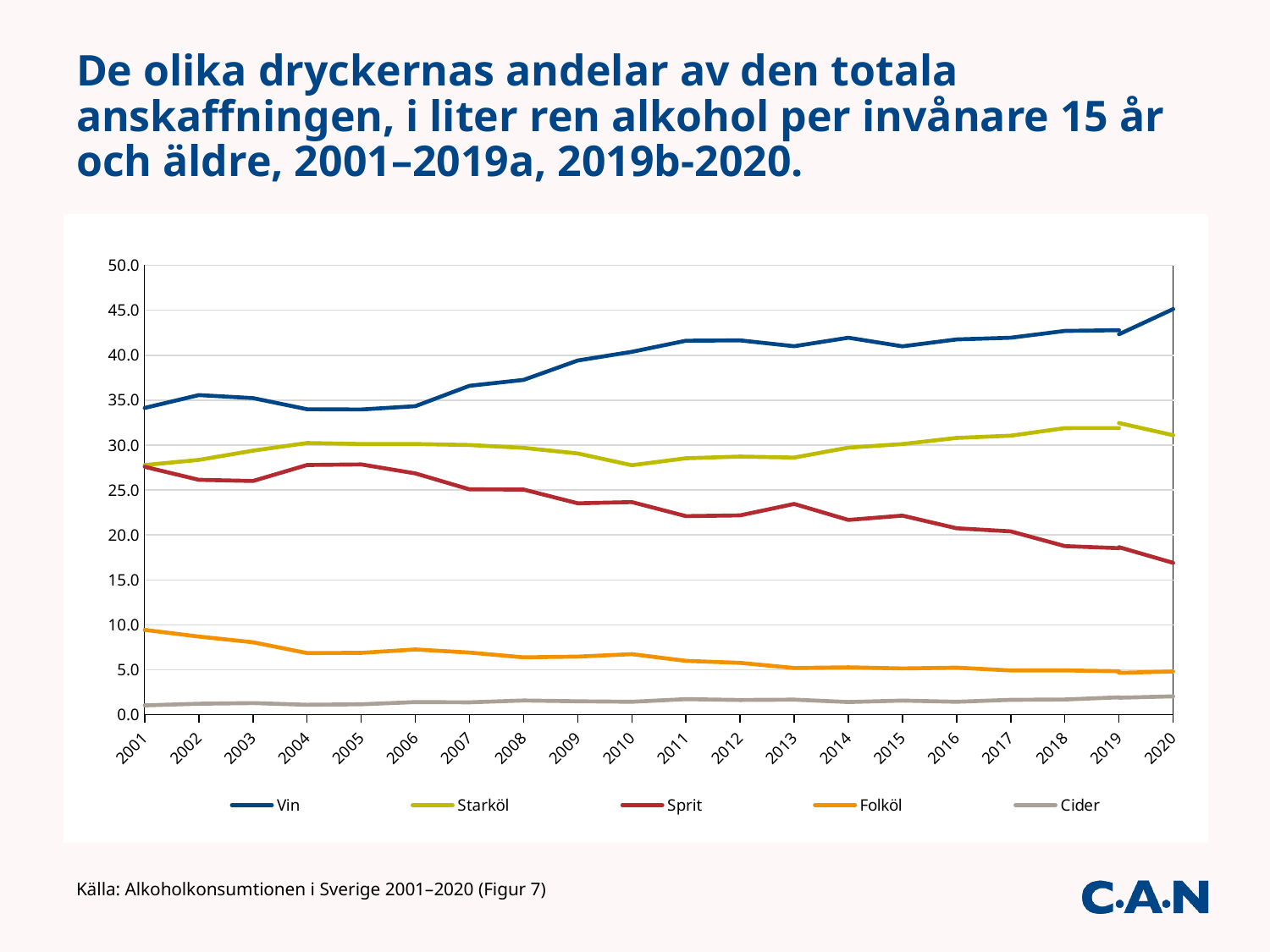
How many series does the legend list? 5 How many years are shown along the x axis? 20 Which series has the highest value in 2020? Vin Is the value for Sprit in 2020 greater or less than 20.0? less What kind of chart is shown on the slide? Line chart Does the Sprit series generally rise or fall from 2001 to 2020? Fall Does the Vin series generally rise or fall from 2001 to 2020? Rise Is the value for Vin in 2020 greater or less than 40.0? greater In 2020, which is larger: Starköl or Sprit? Starköl What colour is the Vin line in the legend? Dark blue Is the value for Folköl in 2001 greater or less than 10.0? less Which series has the lowest value across the whole period? Cider